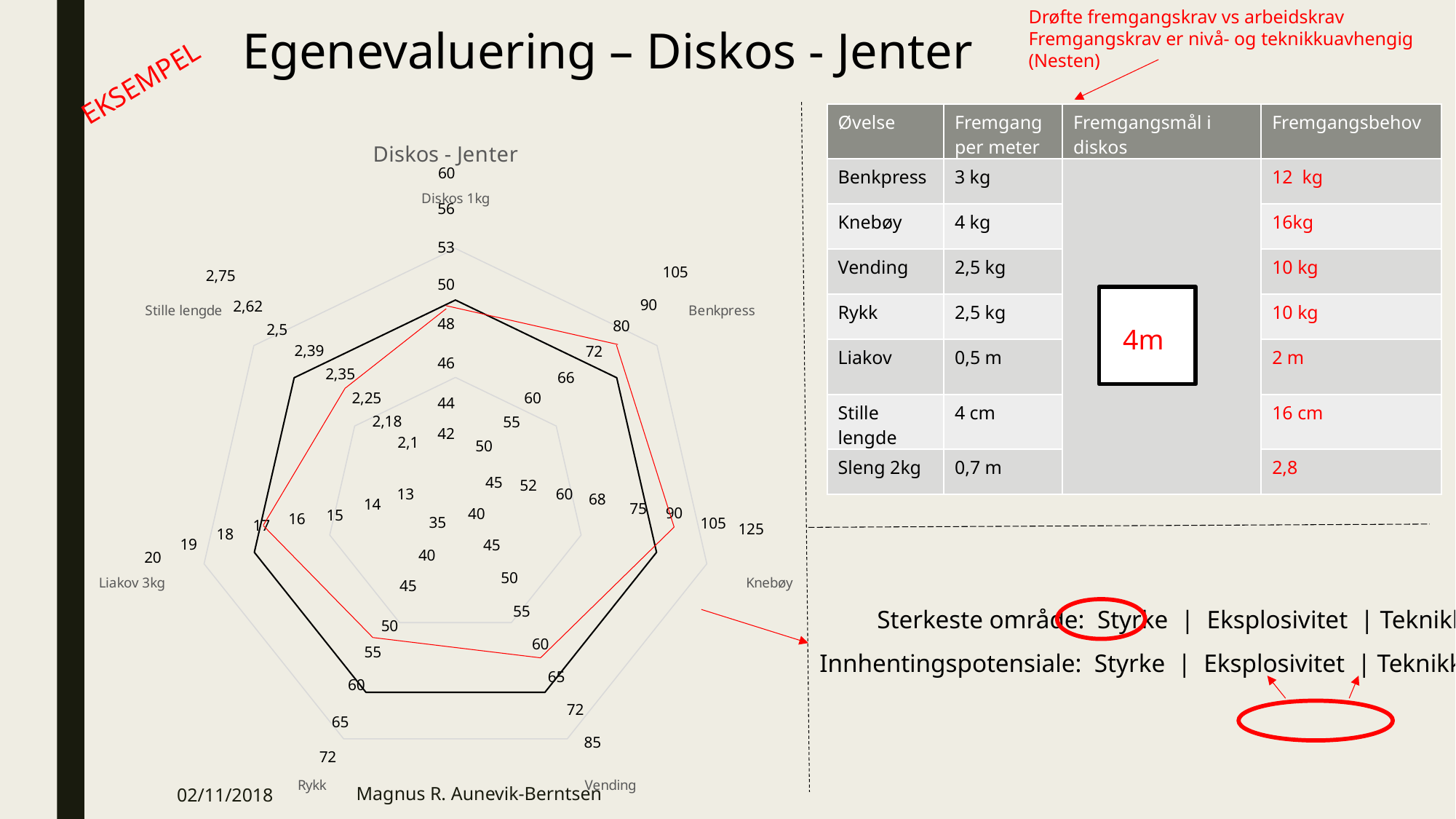
Is the value of the black line on the Diskos 1kg axis greater or less than 44? greater Is the value of the red line on the Benkpress axis greater or less than 60? greater What is the title of the chart? Diskos - Jenter Is the value of the black line on the Liakov 3kg axis greater or less than 15? greater On the Benkpress axis, which line extends further out, the black line or the red line? red line Which category is placed at the top of the radar chart? Diskos 1kg What kind of chart is shown on the slide? Radar chart On the Stille lengde axis, which line extends further out, the black line or the red line? black line On the Rykk axis, which line extends further out, the black line or the red line? black line How many lines (series) are plotted on the radar chart? 2 How many categories (axes) does the radar chart have? 7